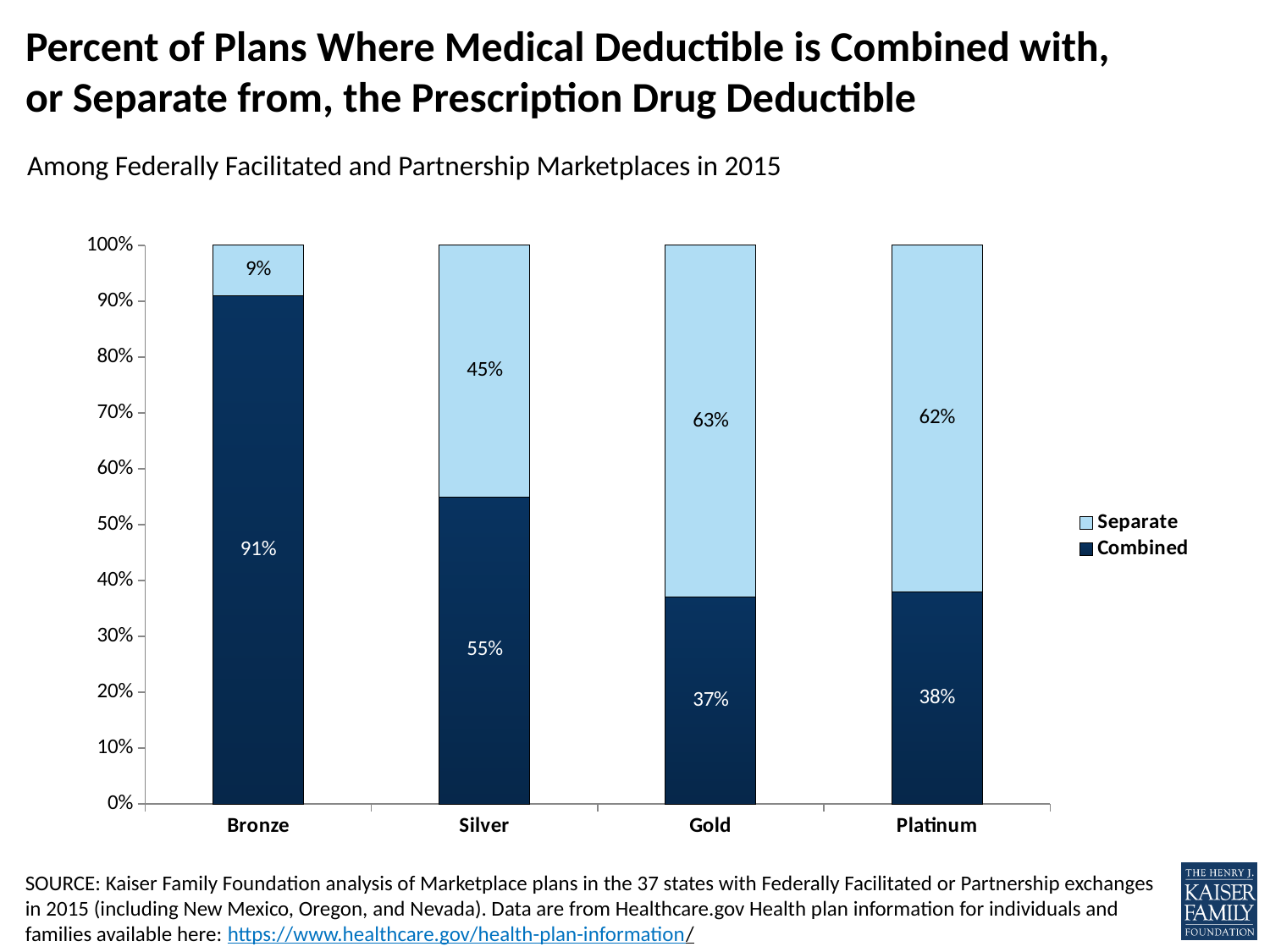
What is the Combined value for Platinum plans? 38% How many series does the legend list? 2 How many metal levels are shown on the x axis? 4 Which metal level has the highest Combined percentage? Bronze Which is larger for Silver plans: the Combined share or the Separate share? Combined What is the total of the stacked bar for Gold plans? 100% What percent of Gold plans have a Separate deductible? 63% What is the Separate value for Silver plans? 45% What percent of Bronze plans have a Combined deductible? 91% What is the difference between the Combined percentages for Bronze and Silver plans? 36% Which metal level has the lowest Separate percentage? Bronze What kind of chart is shown on the slide? Stacked bar chart